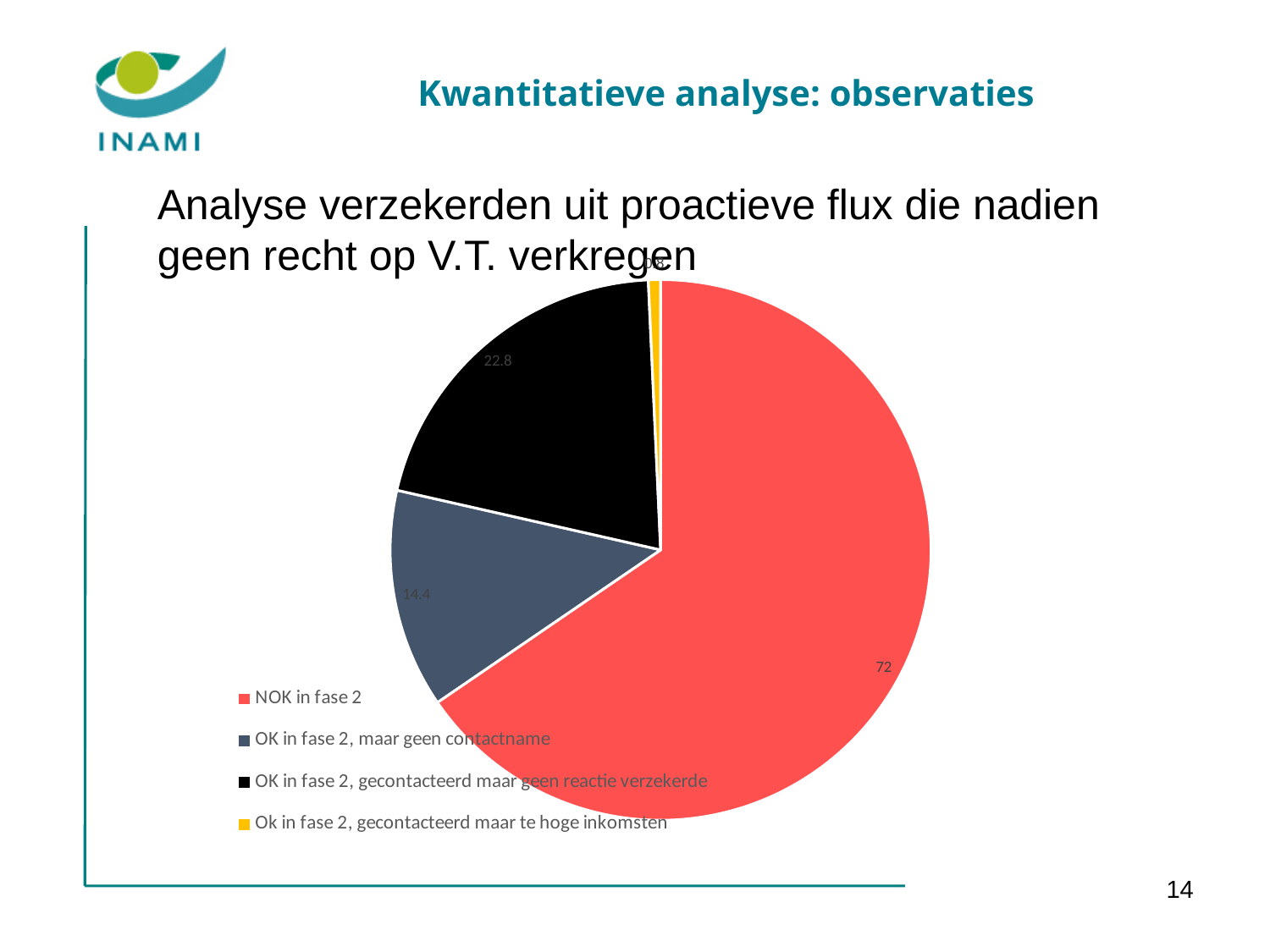
How many categories does the pie chart have? 4 Which is larger: the slice for 'OK in fase 2, maar geen contactname' or the slice for 'OK in fase 2, gecontacteerd maar geen reactie verzekerde'? OK in fase 2, gecontacteerd maar geen reactie verzekerde Which category has the largest slice of the pie? NOK in fase 2 What is the value shown for the 'NOK in fase 2' slice? 72 What type of chart is shown on the slide? pie chart How many entries does the legend list? 4 Which category has the smallest slice of the pie? Ok in fase 2, gecontacteerd maar te hoge inkomsten What is the difference between the values for 'NOK in fase 2' and 'OK in fase 2, maar geen contactname'? 57.6 What is the value shown for the 'OK in fase 2, gecontacteerd maar geen reactie verzekerde' slice? 22.8 What colour is the 'NOK in fase 2' slice? red What is the difference between the values for 'OK in fase 2, gecontacteerd maar geen reactie verzekerde' and 'OK in fase 2, maar geen contactname'? 8.4 What is the value shown for the 'OK in fase 2, maar geen contactname' slice? 14.4